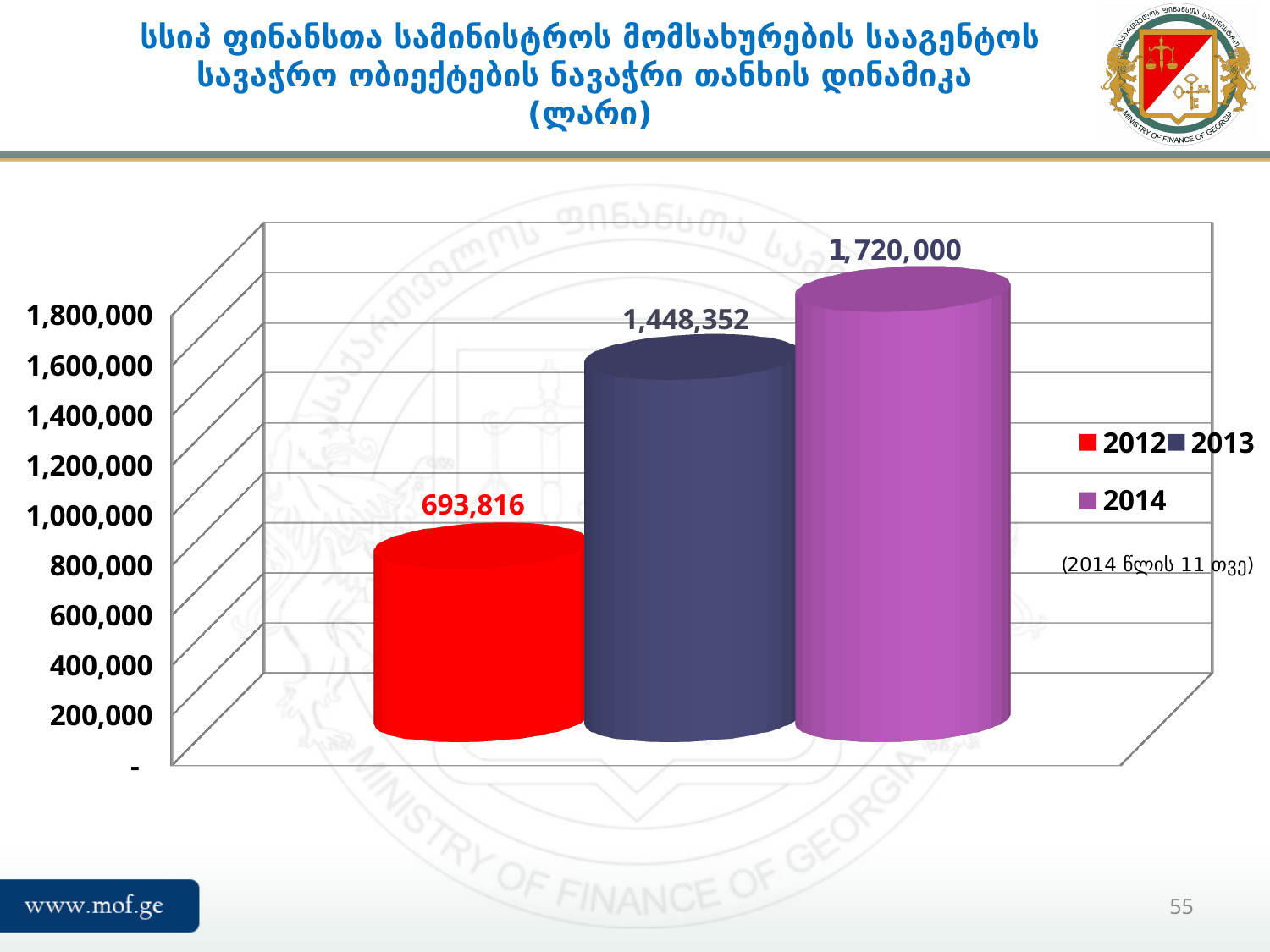
Which year has the highest value? 2014 What is the value for 2012? 693,816 What is the value for 2013? 1,448,352 What is the difference between the values for 2014 and 2013? 271,648 What is the difference between the values for 2013 and 2012? 754,536 How many entries does the legend list? 3 How many bars are plotted on the chart? 3 What is the value for 2014? 1,720,000 Which year has the lowest value? 2012 Which is larger, the value for 2012 or the value for 2013? 2013 What kind of chart is shown on the slide? bar chart Is the value for 2012 greater or less than 800,000? less